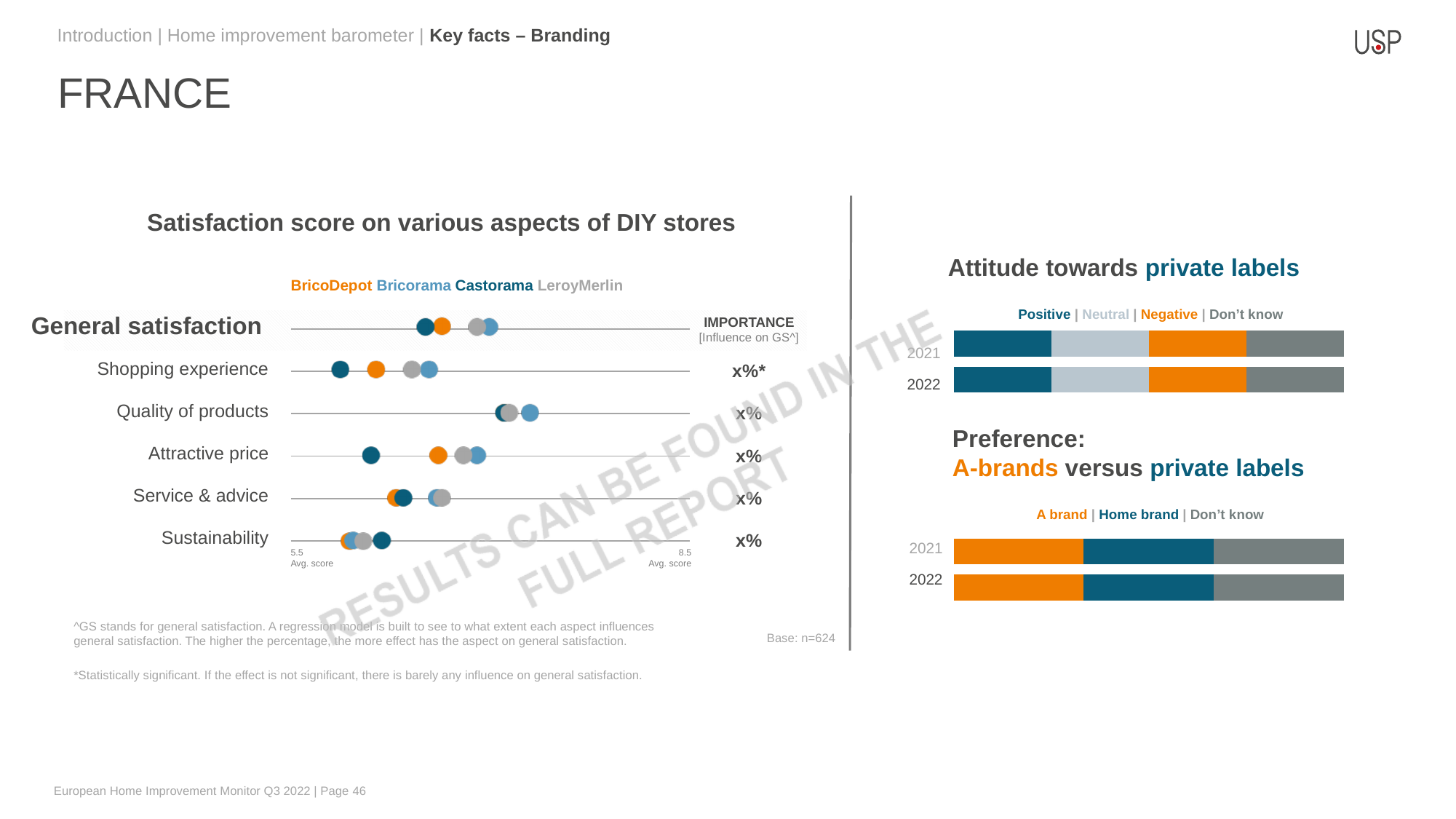
What kind of chart is the 'Preference: A-brands versus private labels' chart? Bar chart On the 'Satisfaction score on various aspects of DIY stores' chart, which store has the highest score for Shopping experience? Bricorama On the 'Satisfaction score on various aspects of DIY stores' chart, which aspect has the lowest scores across the stores? Sustainability On the 'Satisfaction score on various aspects of DIY stores' chart, how many stores does the legend list? 4 On the 'Preference: A-brands versus private labels' chart, how many years are shown? 2 On the 'Attitude towards private labels' chart, how many categories does the legend list? 4 On the 'Satisfaction score on various aspects of DIY stores' chart, which store has the highest score for Quality of products? Bricorama On the 'Satisfaction score on various aspects of DIY stores' chart, which aspect's importance value is marked as statistically significant with an asterisk? Shopping experience On the 'Satisfaction score on various aspects of DIY stores' chart, how many aspects are listed? 6 On the 'Satisfaction score on various aspects of DIY stores' chart, which store has the lowest score for Attractive price? Castorama On the 'Satisfaction score on various aspects of DIY stores' chart, which store has the lowest score for Shopping experience? Castorama On the 'Satisfaction score on various aspects of DIY stores' chart, which aspect has the highest scores across the stores? Quality of products